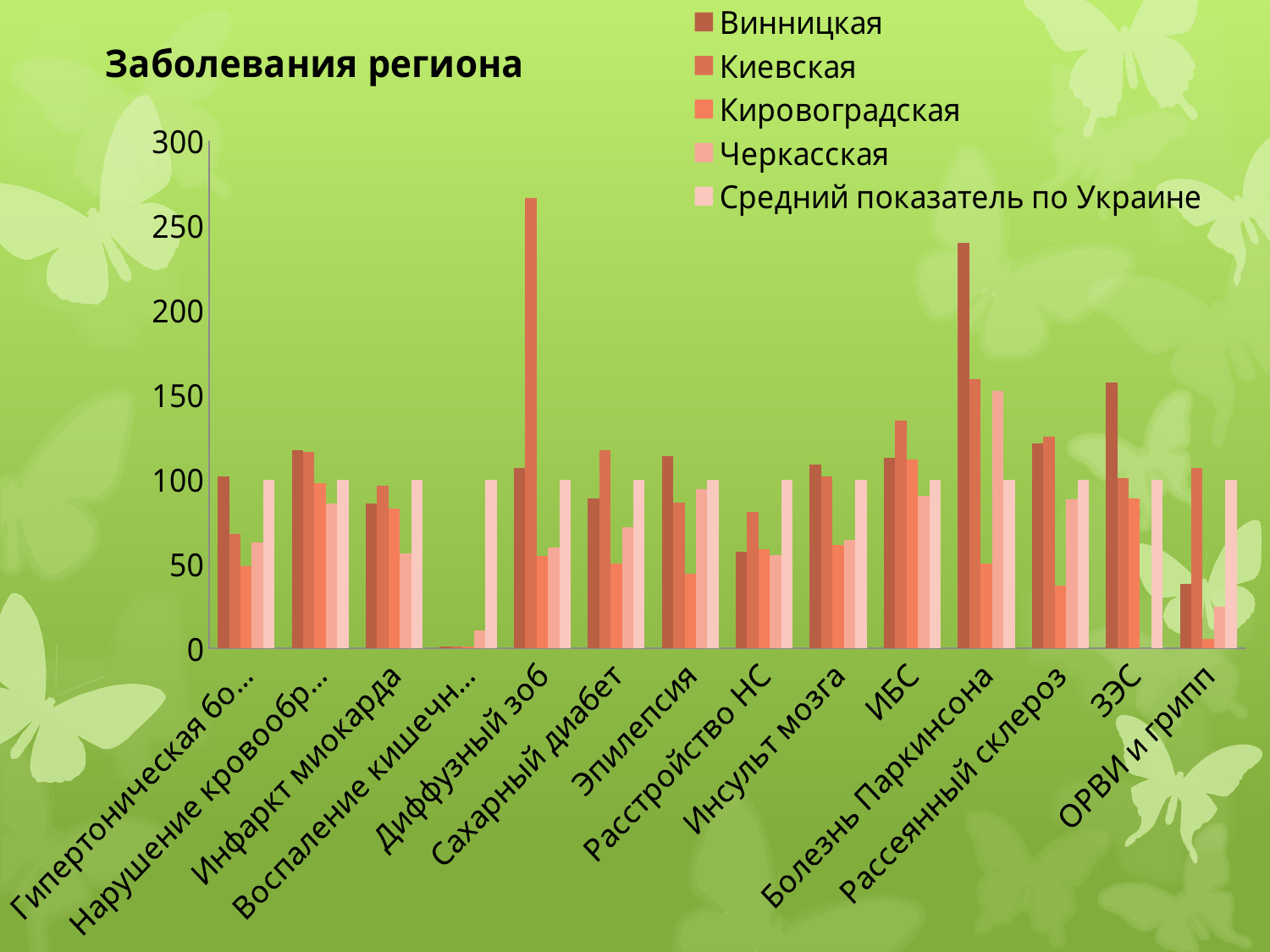
How many disease categories are shown on the x axis? 14 Is the value for Винницкая for Болезнь Паркинсона greater or less than 200? greater Is the value for Винницкая for ЗЭС greater or less than 100? greater Which series has the highest value for Диффузный зоб? Киевская What kind of chart is shown on the slide? bar chart For which category is the Винницкая value highest? Болезнь Паркинсона Is the value for Кировоградская for Диффузный зоб greater or less than 250? less What is the title of the chart? Заболевания региона How many series does the legend list? 5 Which series is listed first in the legend? Винницкая For Болезнь Паркинсона, which is larger: the value for Кировоградская or for Черкасская? Черкасская